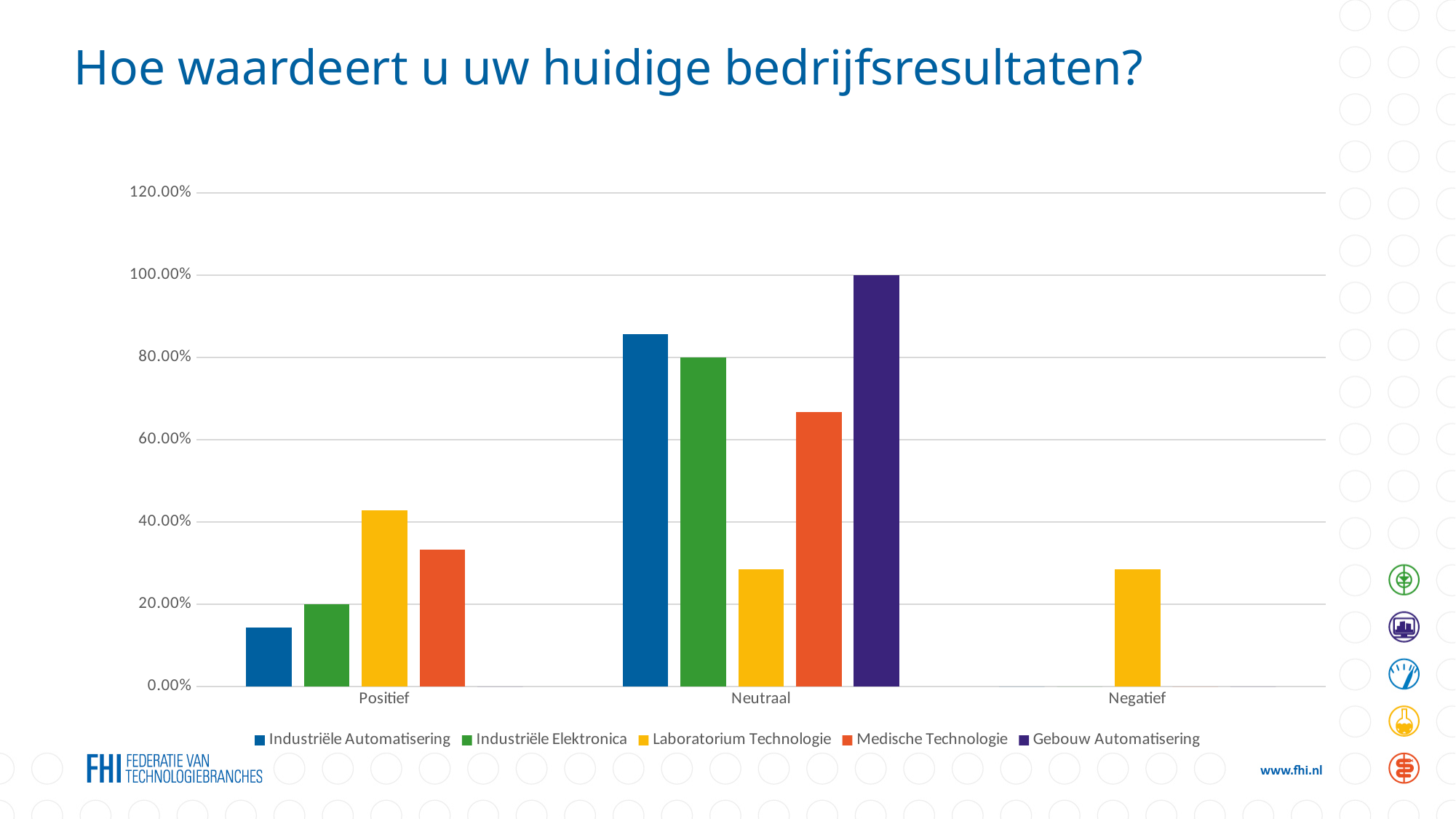
In the Positief category, which is larger: Laboratorium Technologie or Medische Technologie? Laboratorium Technologie What is the value for Industriële Elektronica in the Neutraal category? 80.00% Which series has the highest value in the Neutraal category? Gebouw Automatisering Is the value for Laboratorium Technologie in the Positief category greater or less than 40.00%? greater Is the value for Laboratorium Technologie in the Negatief category greater or less than 40.00%? less How many categories are shown on the x axis? 3 Which series has the lowest value in the Positief category? Gebouw Automatisering Is the value for Medische Technologie in the Neutraal category greater or less than 60.00%? greater What is the value for Gebouw Automatisering in the Neutraal category? 100.00% What kind of chart is shown on the slide? bar chart How many series does the legend list? 5 Which series is the only one with a bar in the Negatief category? Laboratorium Technologie